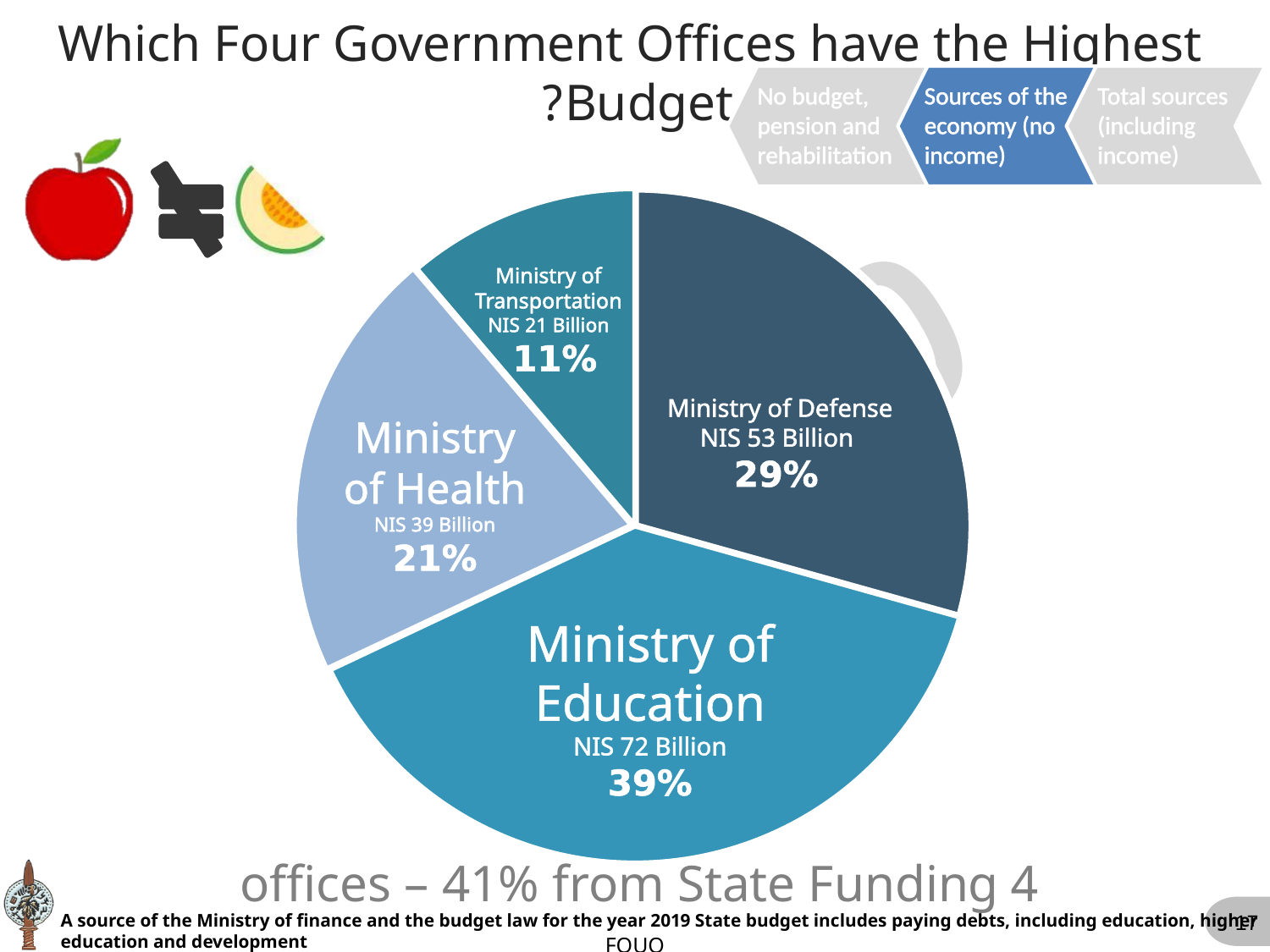
What kind of chart is shown on the slide? pie chart What percentage share does the Ministry of Transportation slice show? 11% What is the title of the slide containing the pie chart? Which Four Government Offices have the Highest Budget? What is the budget of the Ministry of Education shown on the pie chart? NIS 72 Billion How many slices does the pie chart have? 4 Which ministry has the smallest slice of the pie chart? Ministry of Transportation Which ministry has the largest slice of the pie chart? Ministry of Education What is the budget of the Ministry of Defense shown on the pie chart? NIS 53 Billion Which has a larger budget, the Ministry of Health or the Ministry of Transportation? Ministry of Health What percentage share does the Ministry of Health slice show? 21% What is the difference in percentage share between the Ministry of Defense and the Ministry of Health? 8% What is the difference in budget between the Ministry of Education and the Ministry of Defense? NIS 19 Billion